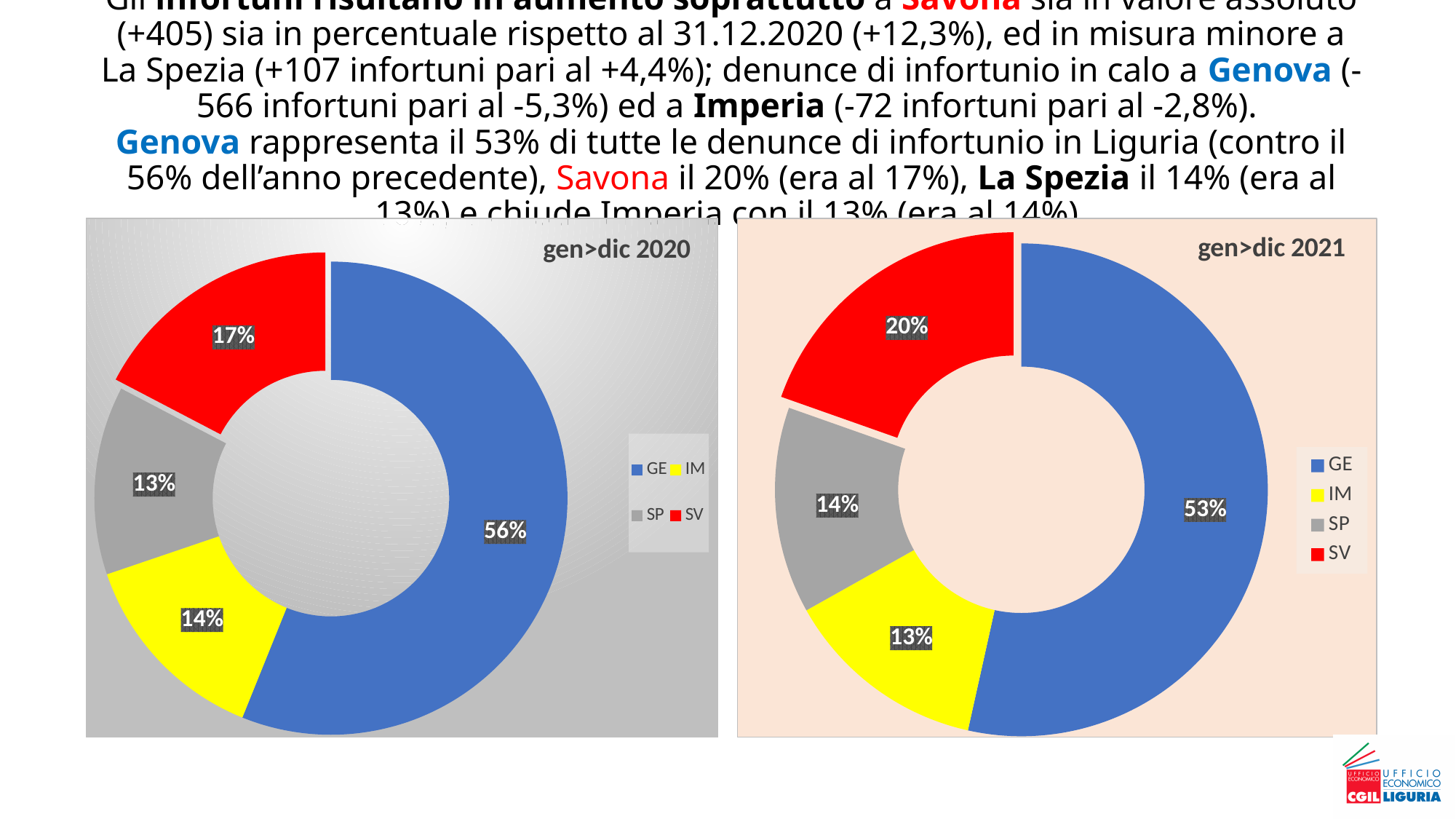
In the 'gen>dic 2021' chart, what share does SV have? 20% What kind of chart is the 'gen>dic 2021' chart? Doughnut chart In the 'gen>dic 2021' chart, what is the difference between the shares of GE and SV? 33% In the 'gen>dic 2020' chart, what share does SP have? 13% How many entries does the legend of the 'gen>dic 2020' chart list? 4 In the 'gen>dic 2020' chart, which category has the smallest share? SP In the 'gen>dic 2021' chart, which category has the largest share? GE In the 'gen>dic 2020' chart, which is larger, the share of SV or the share of IM? SV How many categories are shown in the 'gen>dic 2021' chart? 4 In the 'gen>dic 2021' chart, what share does IM have? 13% In the 'gen>dic 2020' chart, what share does GE have? 56% In the 'gen>dic 2021' chart, what colour is the SV slice? Red